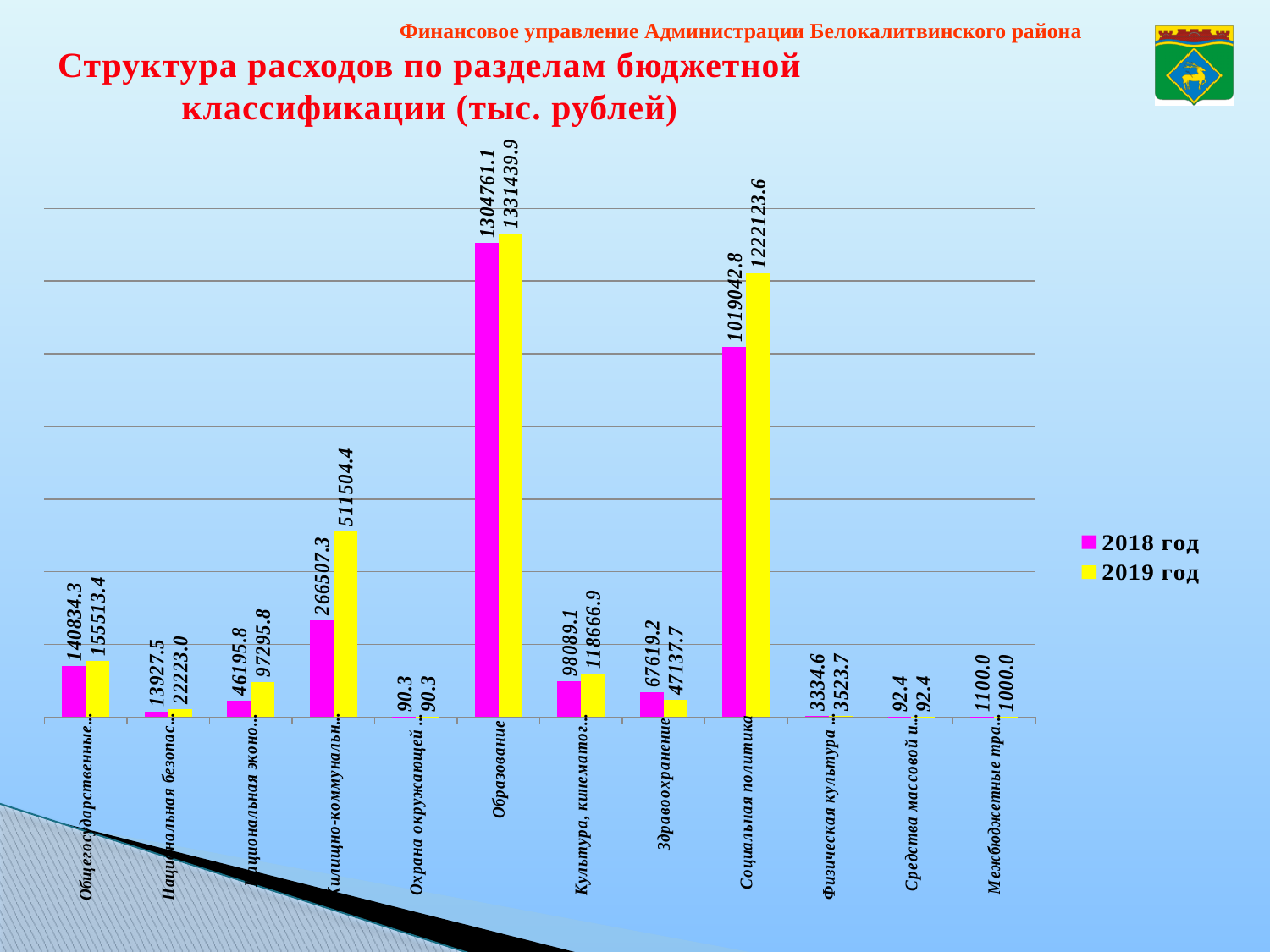
What kind of chart is shown on the slide? bar chart Which category has the highest value in 2019 год? Образование What is the value for Социальная политика in 2019 год? 1222123.6 What is the difference between the 2018 год and 2019 год values for Здравоохранение? 20481.5 What is the smallest value shown for 2018 год? 90.3 Which colour represents 2019 год in the legend? yellow For Здравоохранение, which year has the larger value, 2018 год or 2019 год? 2018 год How many categories are shown on the x axis? 12 How many series does the legend list? 2 What is the difference between the 2019 год and 2018 год values for Образование? 26678.8 What is the value for Здравоохранение in 2019 год? 47137.7 What is the value for Образование in 2018 год? 1304761.1